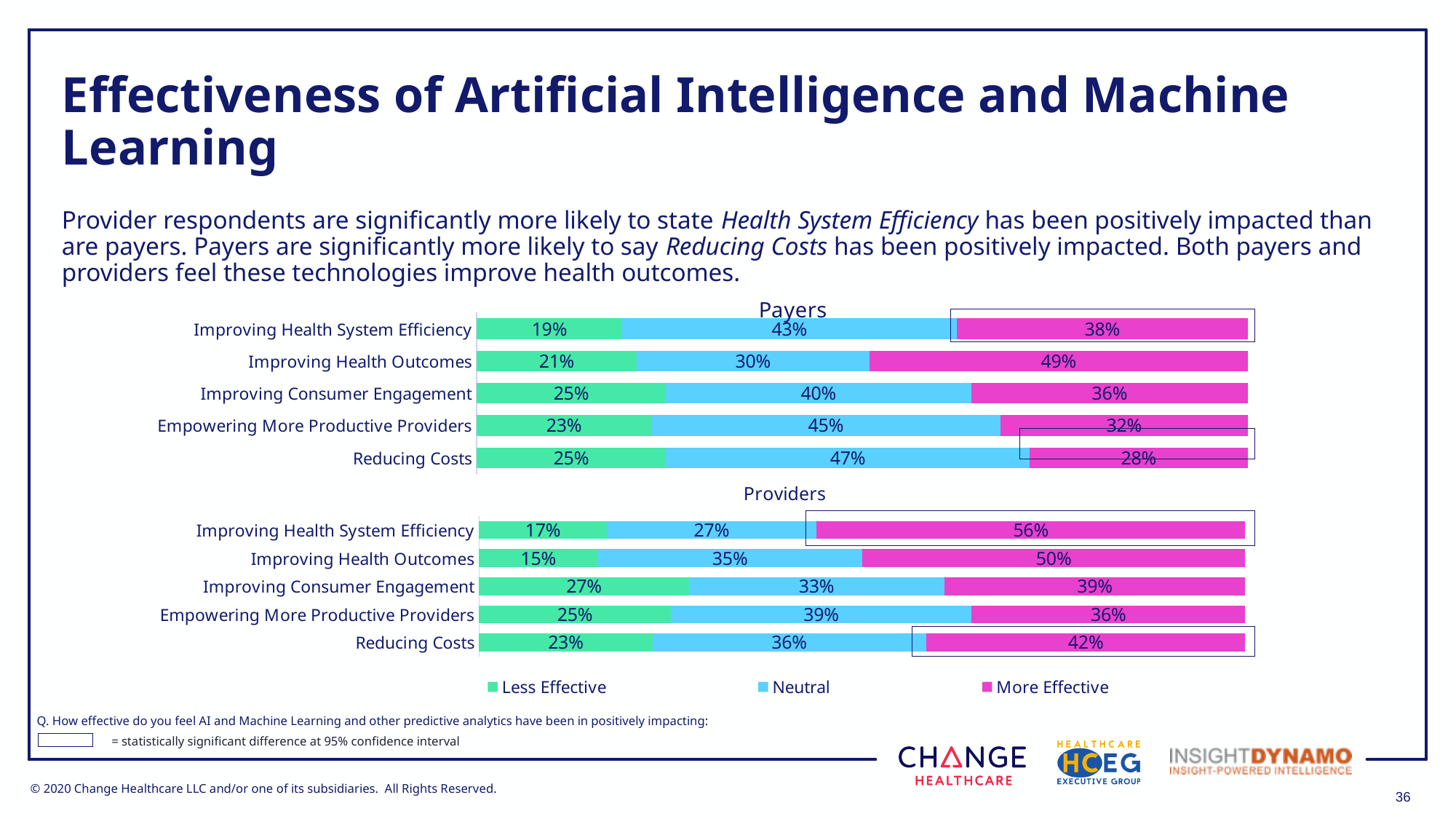
What is the difference between the More Effective value for Improving Health System Efficiency in the Providers chart and in the Payers chart? 18 percentage points In the Providers chart, which category has the lowest Less Effective value? Improving Health Outcomes In the Payers chart, which category has the lowest More Effective value? Reducing Costs How many series does the legend list? 3 In the Providers chart, which category has the highest More Effective value? Improving Health System Efficiency Which is larger: the More Effective value for Reducing Costs in the Payers chart or in the Providers chart? Providers In the Payers chart, which is larger for Improving Consumer Engagement: the Neutral value or the More Effective value? Neutral In the Payers chart, what percentage of respondents rated Improving Health Outcomes as More Effective? 49% In the Payers chart, what is the total of the Less Effective and Neutral values for Empowering More Productive Providers? 68% In the Providers chart, what is the Neutral value for Reducing Costs? 36% How many categories are shown in the Payers chart? 5 What type of chart is used for the Providers data? Stacked bar chart